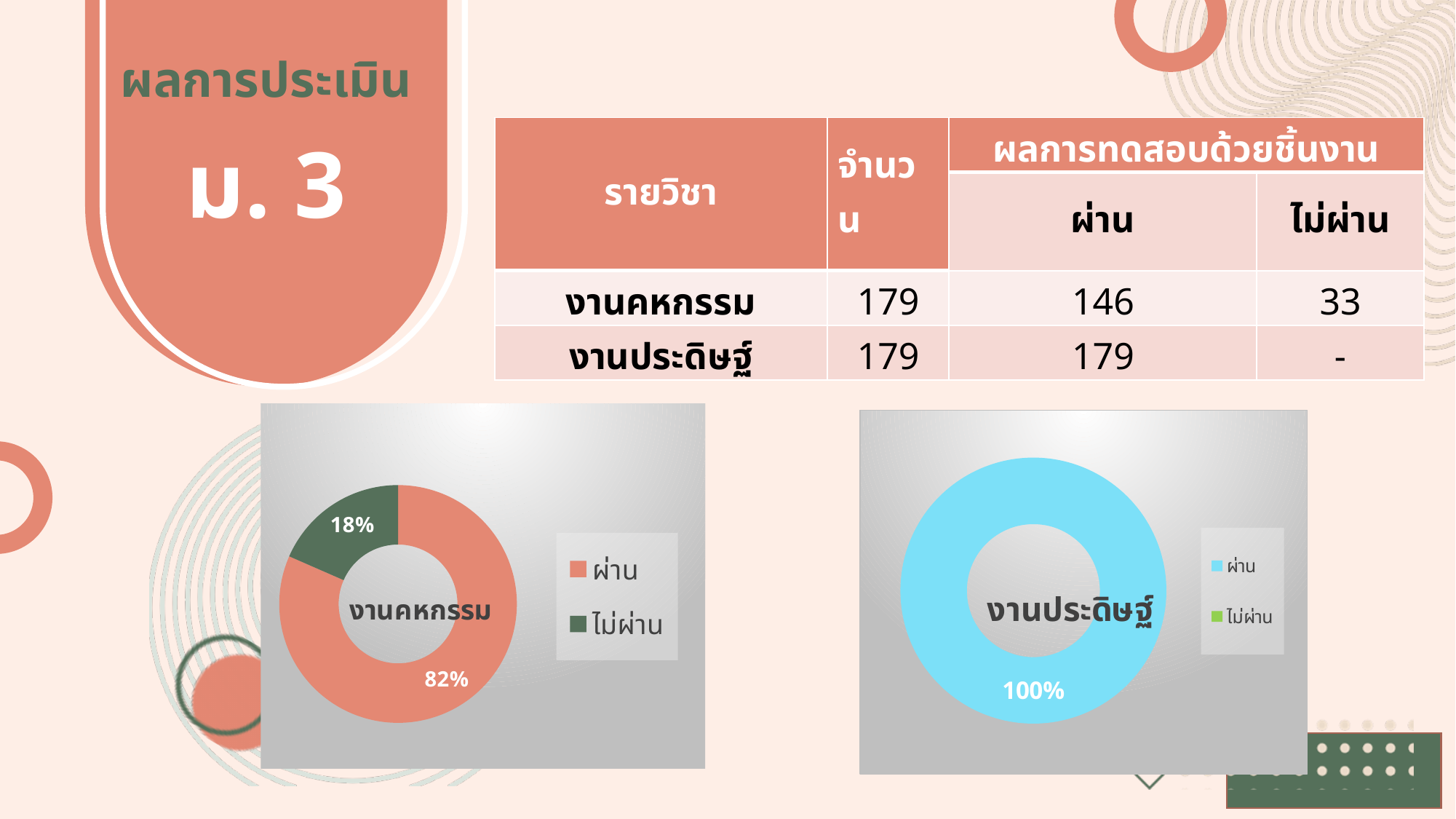
In the right chart (งานประดิษฐ์), what colour is the ผ่าน segment? Light blue How many entries does the legend of the left chart (งานคหกรรม) list? 2 What type of chart is the left chart (งานคหกรรม)? Doughnut chart In the right chart (งานประดิษฐ์), what percentage is shown for ผ่าน? 100% In the left chart (งานคหกรรม), what colour is the ไม่ผ่าน segment? Dark green In the left chart (งานคหกรรม), what percentage is shown for ไม่ผ่าน? 18% In the left chart (งานคหกรรม), which is larger: ผ่าน or ไม่ผ่าน? ผ่าน In the left chart (งานคหกรรม), what percentage is shown for ผ่าน? 82% In the left chart (งานคหกรรม), which category has the largest share? ผ่าน In the left chart (งานคหกรรม), what is the difference in percentage points between ผ่าน and ไม่ผ่าน? 64 In the left chart (งานคหกรรม), which category has the smallest share? ไม่ผ่าน What type of chart is the right chart (งานประดิษฐ์)? Doughnut chart